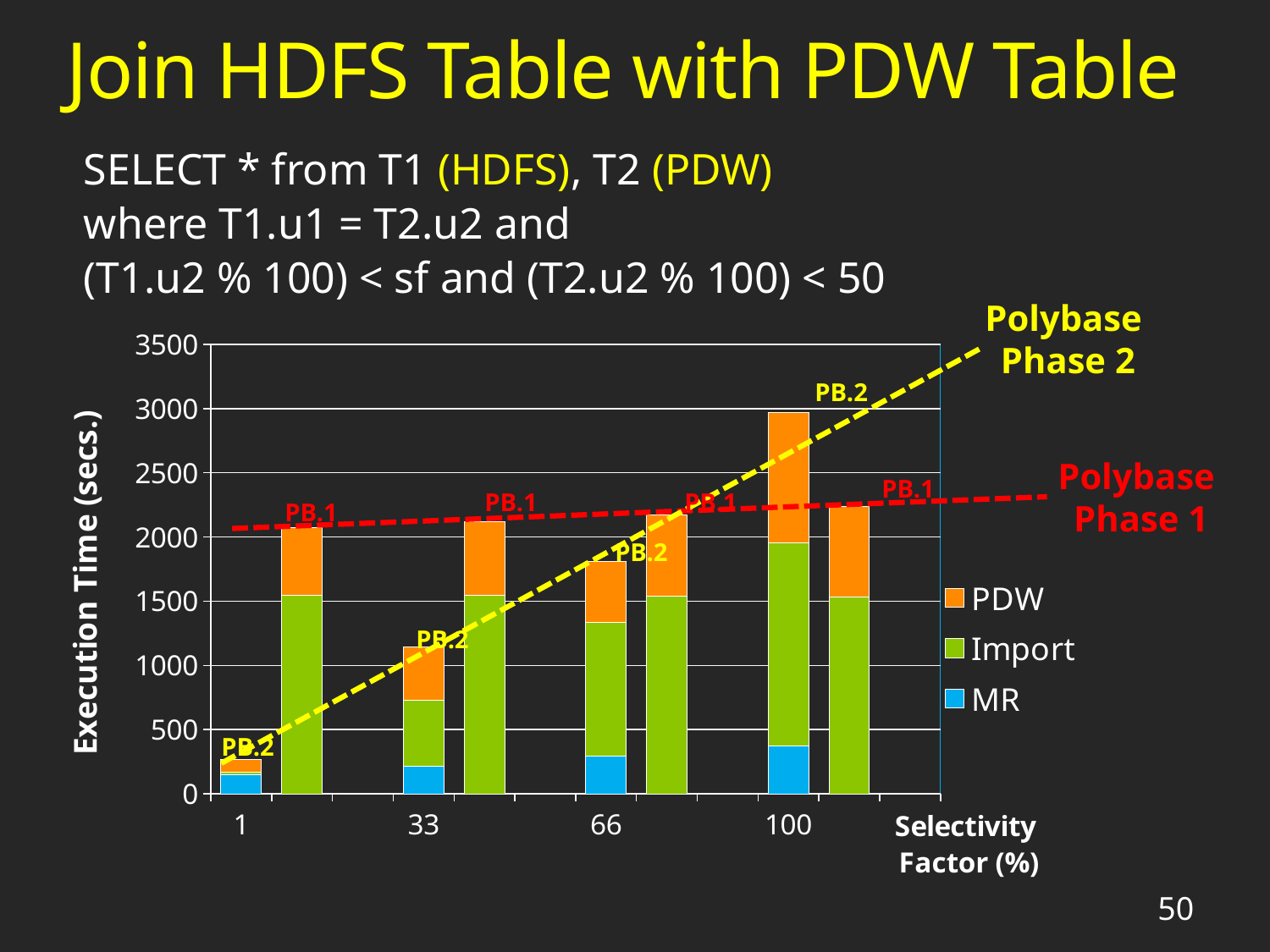
What is the title of the vertical axis? Execution Time (secs.) How many series does the chart's legend list? 3 What kind of chart is shown on the slide? stacked bar chart Is the total execution time for the PB.2 bar at selectivity factor 66 greater or less than 2000? less Is the total execution time for the PB.2 bar at selectivity factor 100 greater or less than 2500? greater How many selectivity factor values are shown on the x axis? 4 Which series are listed in the legend? PDW, Import, MR Do the PB.2 total execution times rise or fall as the selectivity factor increases? rise At selectivity factor 1, which has the larger total execution time, PB.1 or PB.2? PB.1 Is the total execution time for the PB.1 bar at selectivity factor 1 greater or less than 2000? greater Which bar has the highest total execution time? PB.2 at selectivity factor 100